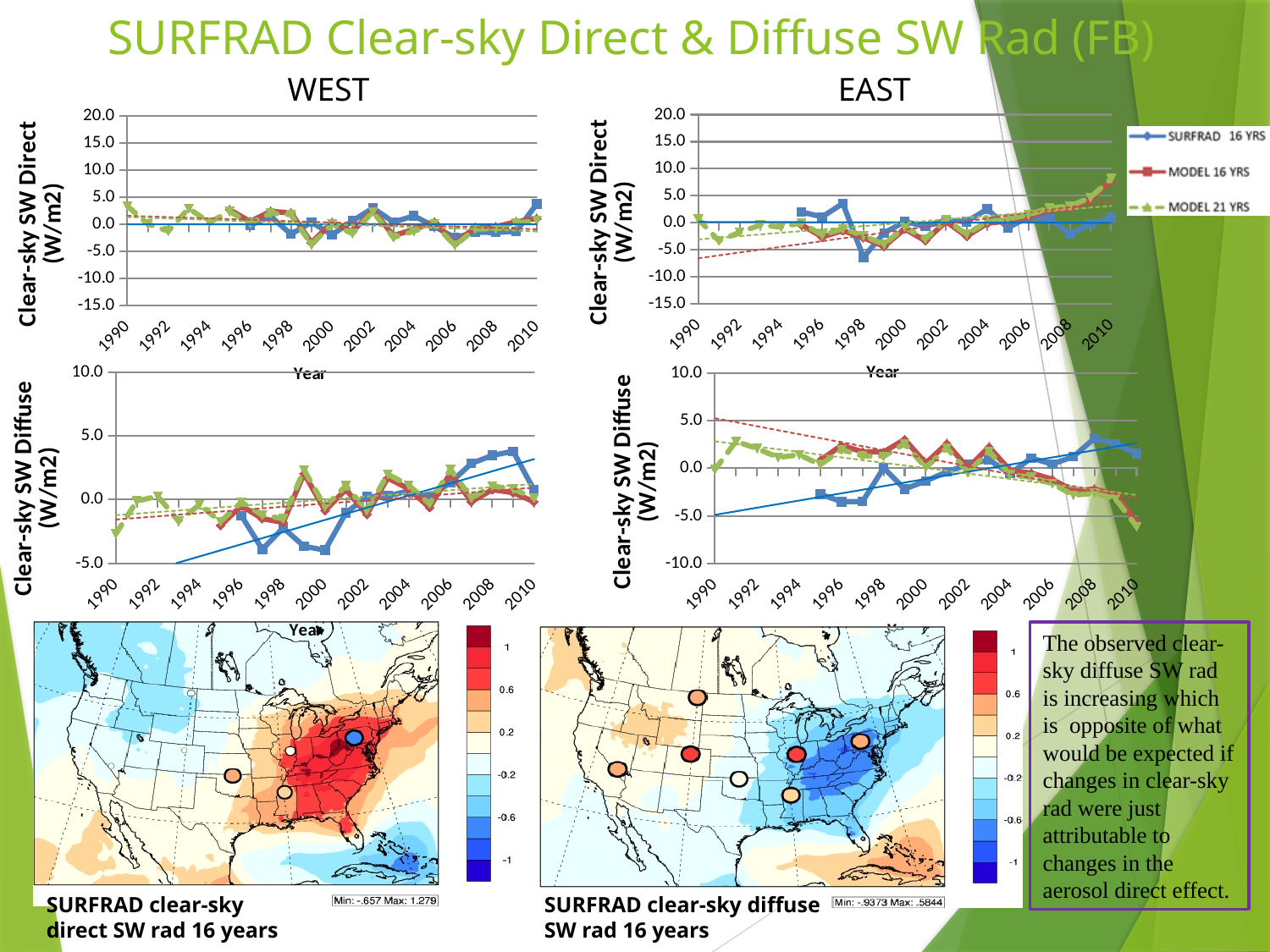
What is the x-axis label on the WEST Clear-sky SW Direct chart? Year In the EAST Clear-sky SW Direct chart, is the SURFRAD 16 YRS value for 1998 greater or less than 0.0? less How many series does the legend on the slide list? 3 In the EAST Clear-sky SW Diffuse chart, which is larger for the SURFRAD 16 YRS series: the value in 1996 or the value in 2008? 2008 What are the three series named in the legend? SURFRAD 16 YRS, MODEL 16 YRS, MODEL 21 YRS In the WEST Clear-sky SW Diffuse chart, does the SURFRAD 16 YRS series rise or fall from the mid-1990s to 2010? rise What kind of chart is the WEST Clear-sky SW Direct chart? line chart How many year labels are shown on the x axis of the WEST Clear-sky SW Direct chart? 11 In the EAST Clear-sky SW Diffuse chart, does the SURFRAD 16 YRS series rise or fall from 1996 to 2008? rise In the WEST Clear-sky SW Diffuse chart, is the SURFRAD 16 YRS value for 2008 greater or less than 0.0? greater In the EAST Clear-sky SW Diffuse chart, is the SURFRAD 16 YRS value for 1996 greater or less than 0.0? less In the EAST Clear-sky SW Diffuse chart, does the MODEL 16 YRS series rise or fall from 1990 to 2010? fall